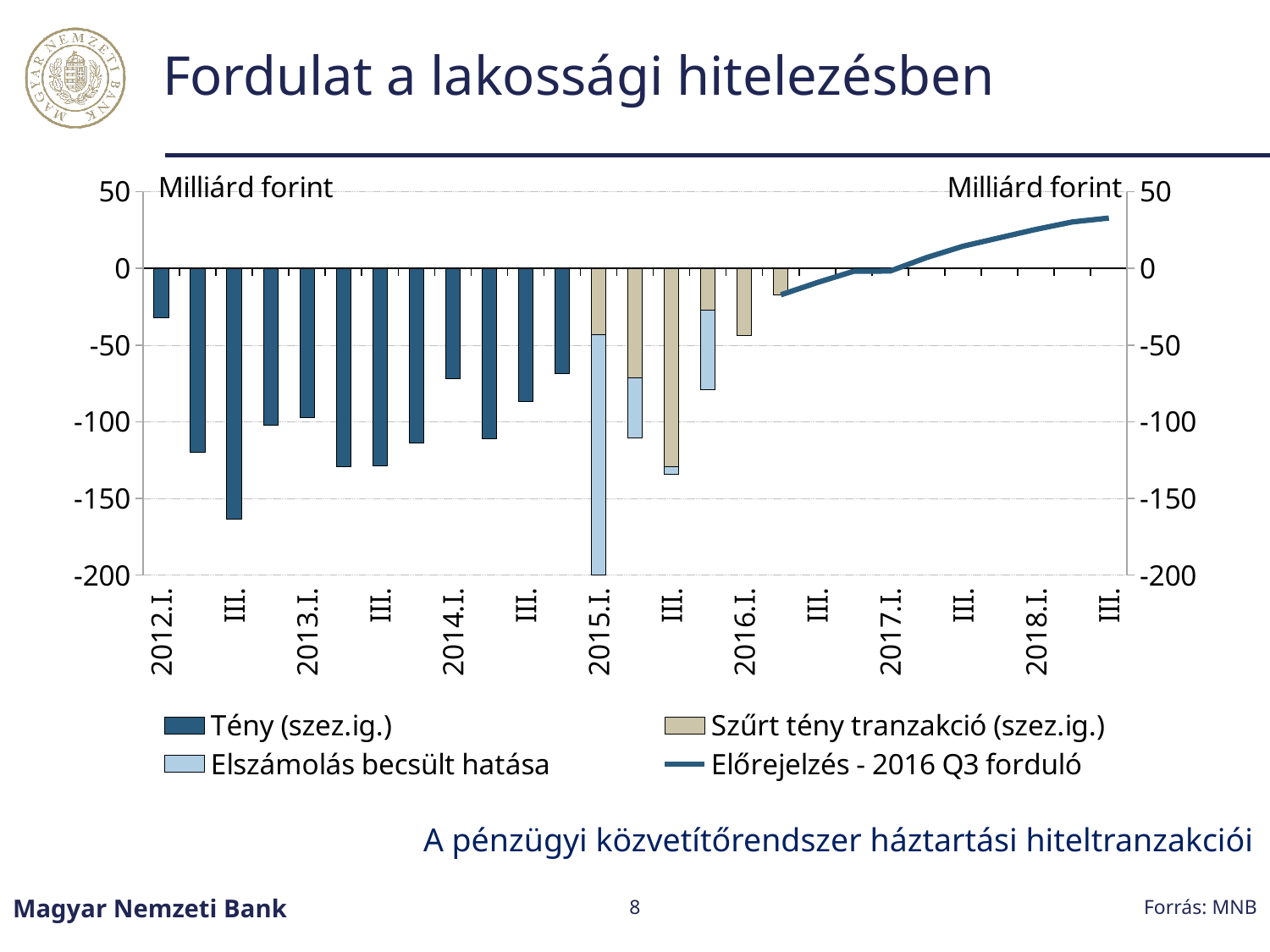
Is the Tény (szez.ig.) value for 2012.I. greater or less than -50? greater Is the Előrejelzés - 2016 Q3 forduló value at 2018.III. greater or less than 0? greater What kind of chart is shown on the slide? A combined bar and line chart How many series does the legend list? 4 Is the Tény (szez.ig.) value for 2014.IV. greater or less than -100? greater In which quarter is the Tény (szez.ig.) bar lowest? 2012.III. Which is larger, the Tény (szez.ig.) value for 2012.I. or for 2012.III.? 2012.I. Which series is drawn as a line rather than bars? Előrejelzés - 2016 Q3 forduló What unit is shown on the vertical axes? Milliárd forint Does the Előrejelzés - 2016 Q3 forduló line rise or fall from 2016.III. to 2018.III.? rise